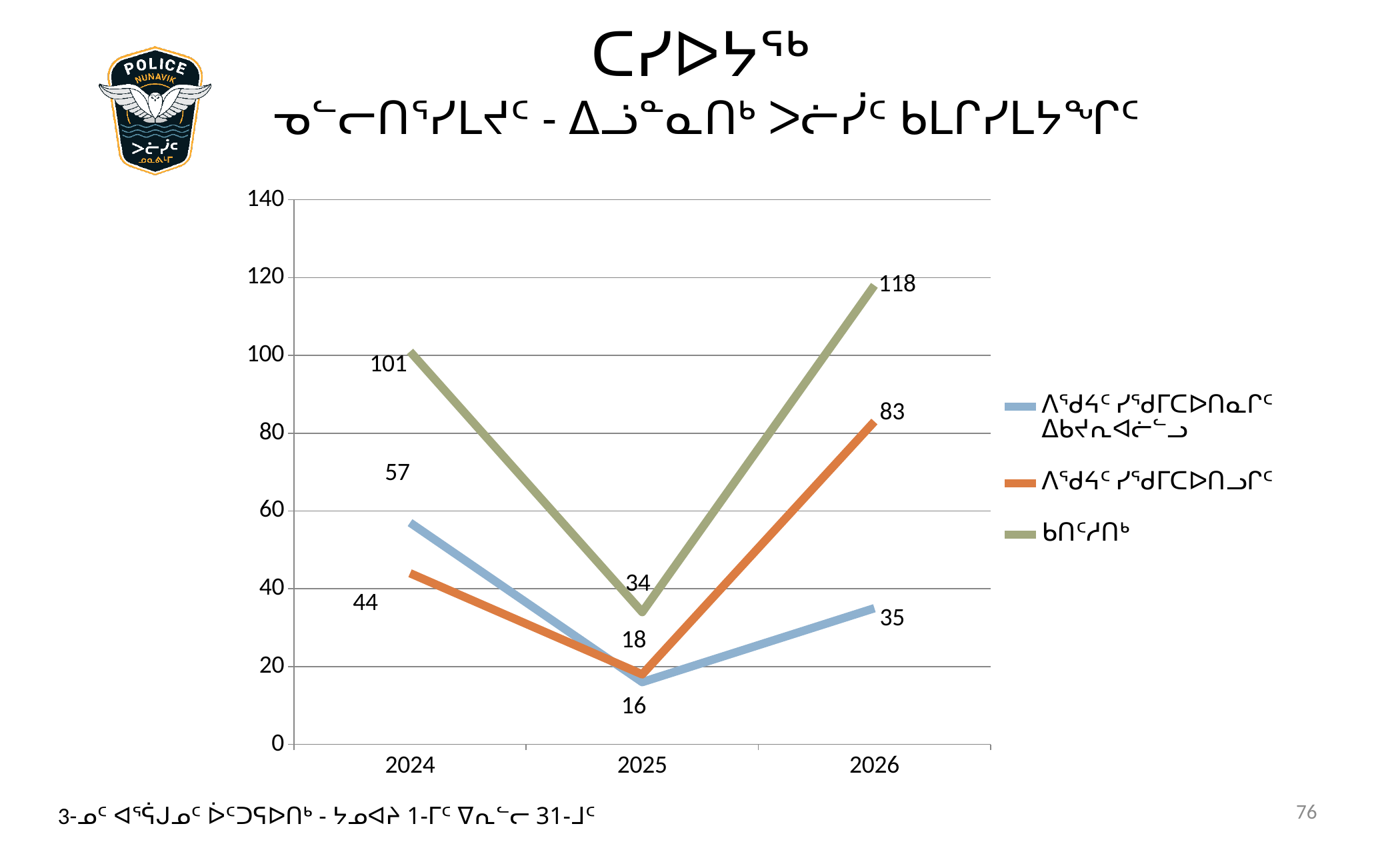
What is the difference between the blue line's values in 2024 and 2025? 41 What is the value of the orange line in 2026? 83 How many series does the legend list? 3 What is the difference between the green line's values in 2026 and 2024? 17 What is the value of the blue line in 2024? 57 In which year does the green line reach its highest value? 2026 In 2026, which is larger: the orange line or the blue line? The orange line What is the value of the green line in 2025? 34 In which year does the blue line reach its lowest value? 2025 Is the value of the green line in 2026 greater or less than 100? greater How many years are shown on the x axis? 3 What kind of chart is shown on the slide? Line chart